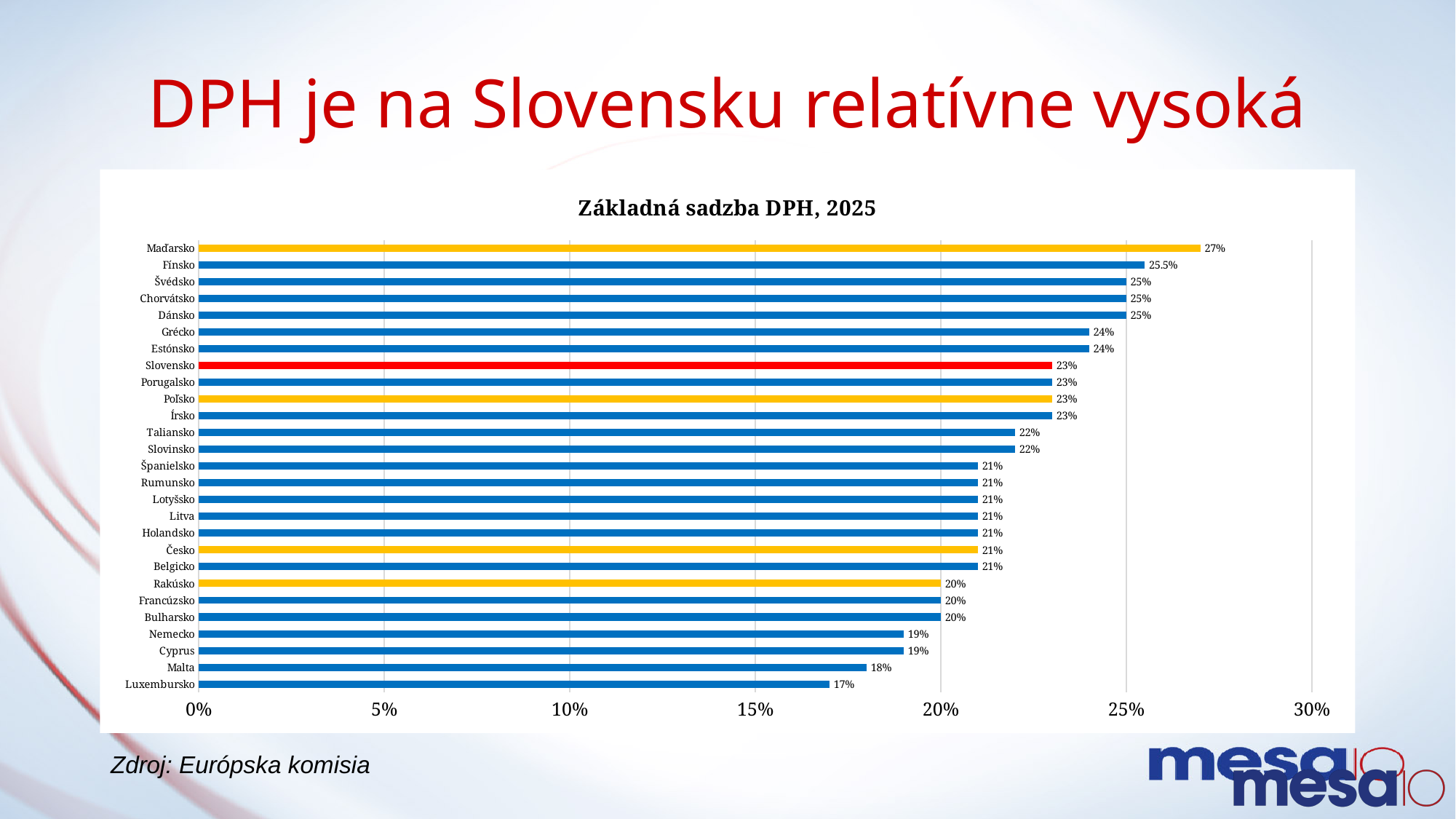
Which country has the highest value? Maďarsko What kind of chart is shown on the slide? bar chart What is the difference between the values for Maďarsko and Slovensko? 4% What is the value for Luxembursko? 17% How many countries are shown in the chart? 27 What is the title of the chart? Základná sadzba DPH, 2025 Which is larger, the value for Grécko or the value for Rakúsko? Grécko What is the value for Slovensko? 23% Is the value for Malta greater or less than 20%? less Which country's bar is coloured red? Slovensko What is the value for Fínsko? 25.5% Which country has the lowest value? Luxembursko